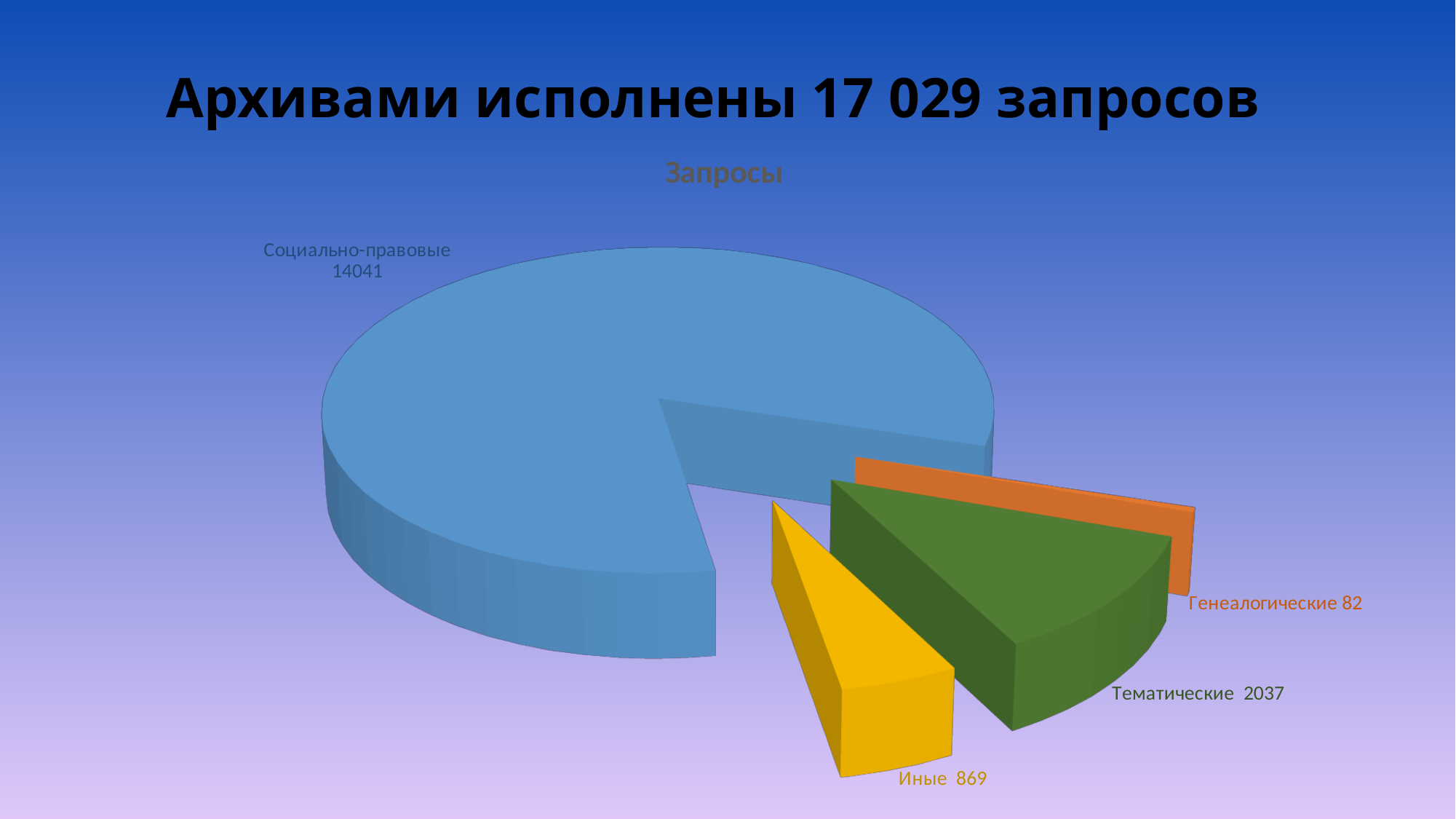
What is the difference between the values for Социально-правовые and Тематические? 12004 What is the value for Тематические? 2037 How many slices does the pie chart have? 4 What is the total of all four slices in the pie chart? 17029 Which category has the smallest slice? Генеалогические Which is larger, the value for Иные or the value for Генеалогические? Иные What is the value for Иные? 869 What is the title of the chart? Запросы Which category has the largest slice? Социально-правовые What is the value for Генеалогические? 82 What type of chart is shown on the slide? Pie chart What is the value for Социально-правовые? 14041